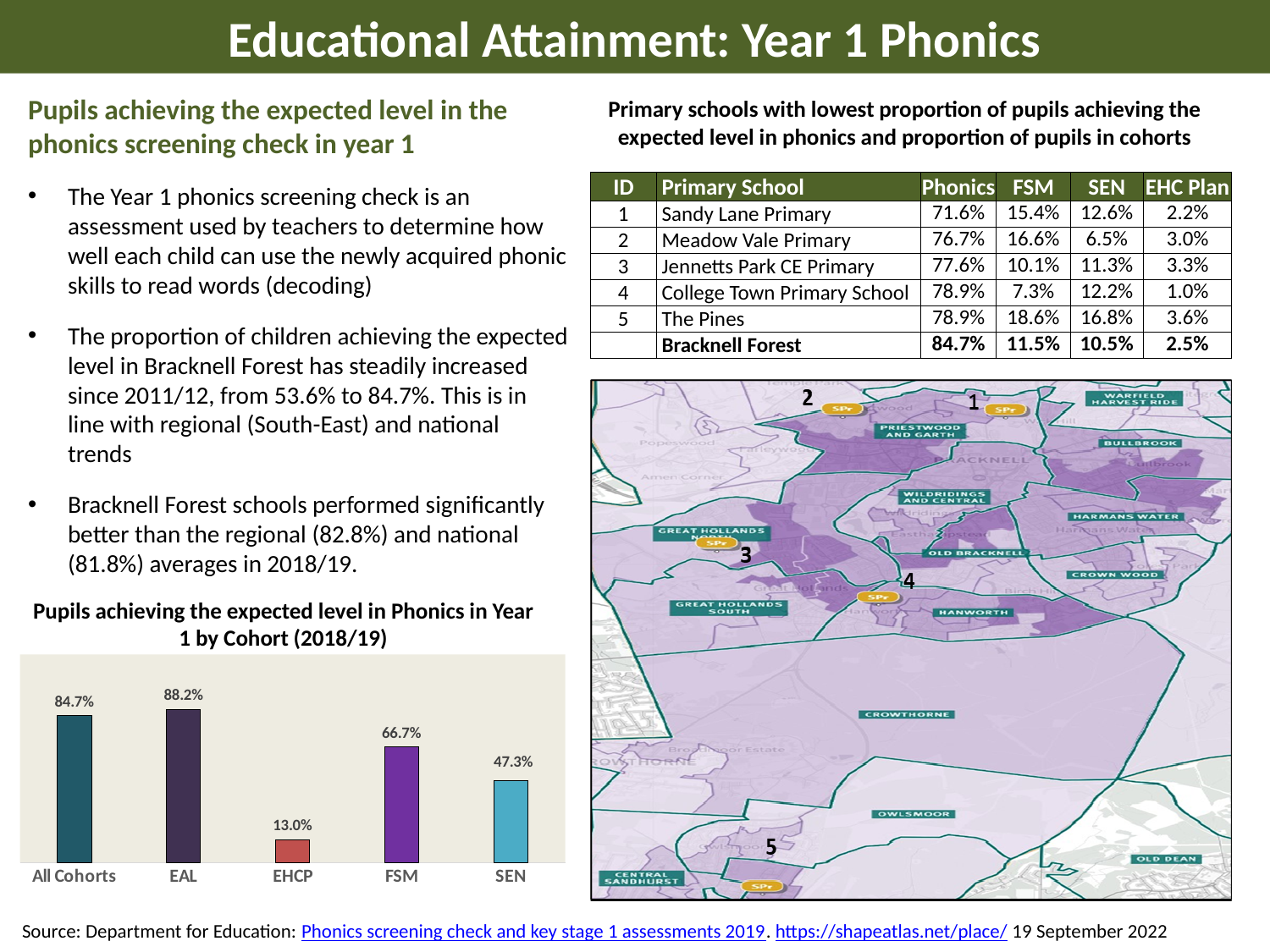
In the chart 'Pupils achieving the expected level in Phonics in Year 1 by Cohort (2018/19)', what is the difference between the values for FSM and SEN? 19.4% In the chart 'Pupils achieving the expected level in Phonics in Year 1 by Cohort (2018/19)', what is the difference between the values for EAL and All Cohorts? 3.5% What is the value for FSM in the chart 'Pupils achieving the expected level in Phonics in Year 1 by Cohort (2018/19)'? 66.7% What is the value for EHCP in the chart 'Pupils achieving the expected level in Phonics in Year 1 by Cohort (2018/19)'? 13.0% What is the value for All Cohorts in the chart 'Pupils achieving the expected level in Phonics in Year 1 by Cohort (2018/19)'? 84.7% In the chart 'Pupils achieving the expected level in Phonics in Year 1 by Cohort (2018/19)', which is larger, the value for FSM or the value for SEN? FSM What kind of chart is 'Pupils achieving the expected level in Phonics in Year 1 by Cohort (2018/19)'? Bar chart Which cohort has the lowest value in the chart 'Pupils achieving the expected level in Phonics in Year 1 by Cohort (2018/19)'? EHCP What is the value for EAL in the chart 'Pupils achieving the expected level in Phonics in Year 1 by Cohort (2018/19)'? 88.2% What is the value for SEN in the chart 'Pupils achieving the expected level in Phonics in Year 1 by Cohort (2018/19)'? 47.3% How many cohorts are shown in the chart 'Pupils achieving the expected level in Phonics in Year 1 by Cohort (2018/19)'? 5 Which cohort has the highest value in the chart 'Pupils achieving the expected level in Phonics in Year 1 by Cohort (2018/19)'? EAL